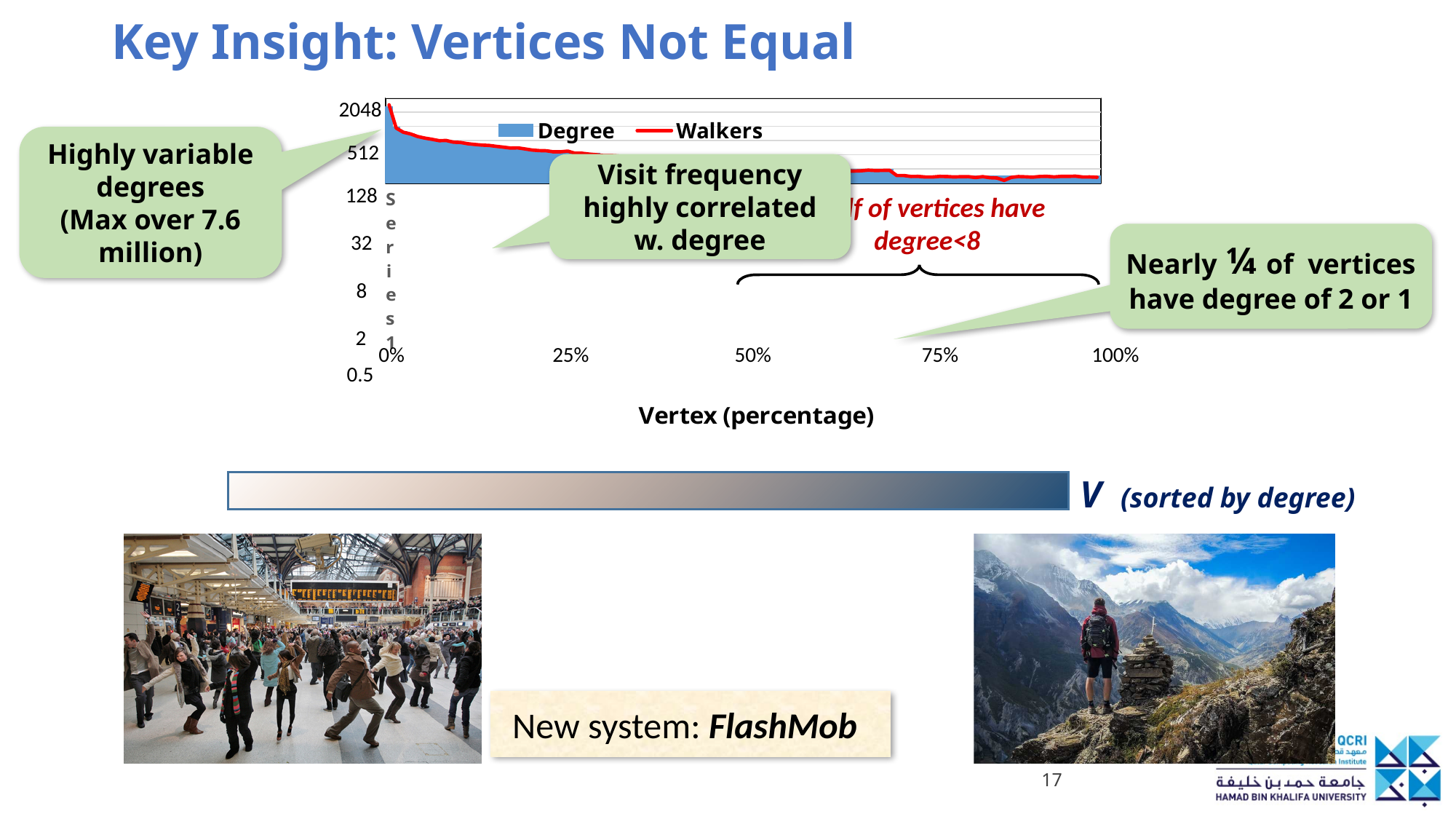
Do the Walkers values rise or fall along the x axis from 0% to 100%? fall Is the Degree value at 0% on the x axis greater or less than 512? greater What is the title of the x axis of the chart? Vertex (percentage) Which series is drawn as a red line in the chart? Walkers How many series does the chart legend list? 2 How many tick labels are shown on the x axis of the chart? 5 Do the Degree values rise or fall as the vertex percentage increases along the x axis? fall What are the two series named in the chart legend? Degree and Walkers